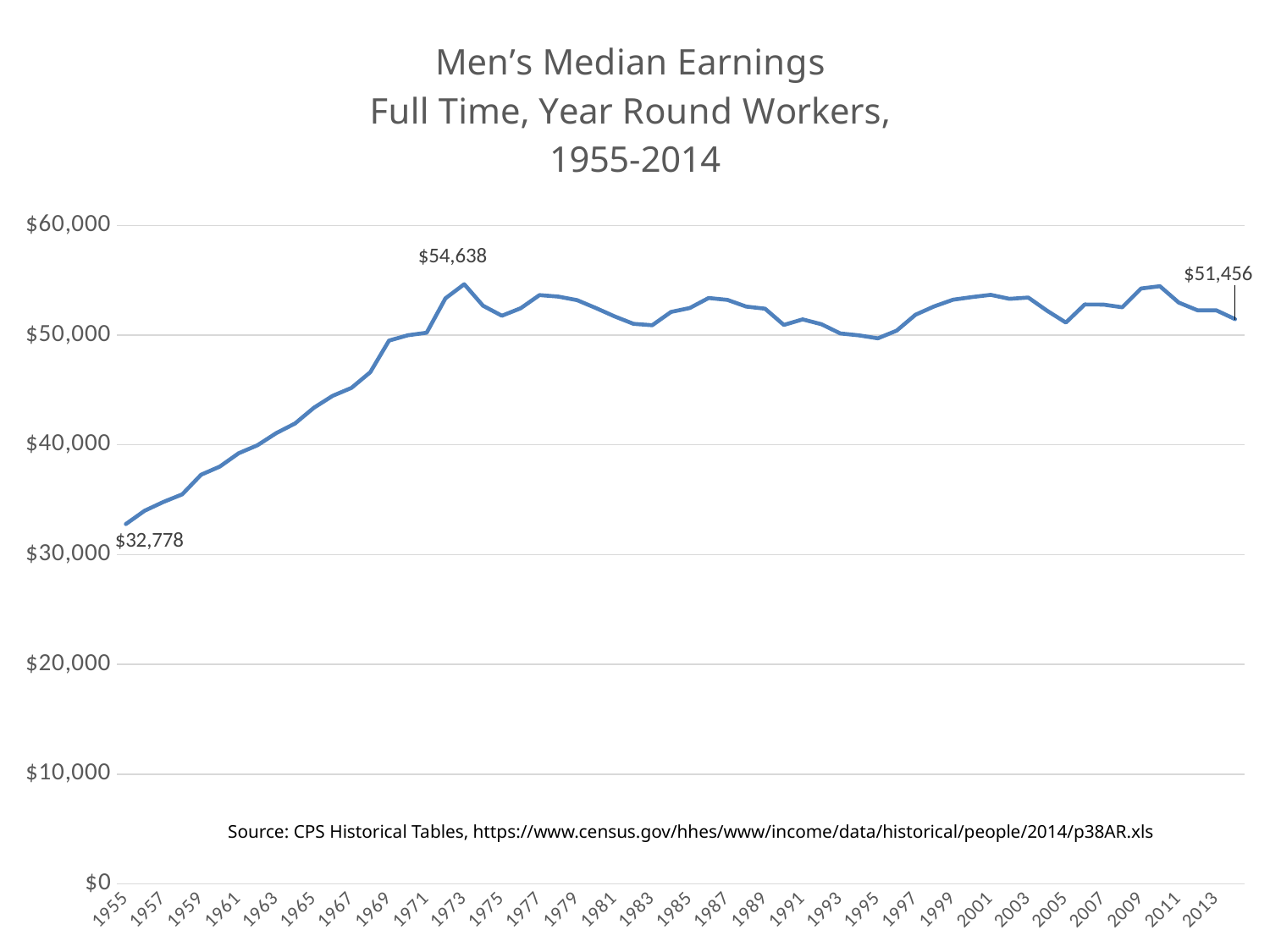
Is the value for 1965 greater or less than $40,000? greater What is the difference between the 1973 value and the 2014 value? $3,182 What is the value of men's median earnings in 1955? $32,778 What kind of chart is shown on the slide? line chart Is the value for 1959 greater or less than $40,000? less What is the title of the chart? Men's Median Earnings Full Time, Year Round Workers, 1955-2014 Do men's median earnings rise or fall from 1955 to 1973? rise What is the difference between the 1973 value and the 1955 value? $21,860 What is the value of men's median earnings in 2014? $51,456 Which year has the higher labeled value, 1973 or 2014? 1973 What is the value of men's median earnings in 1973? $54,638 Which year has the lowest men's median earnings on the chart? 1955